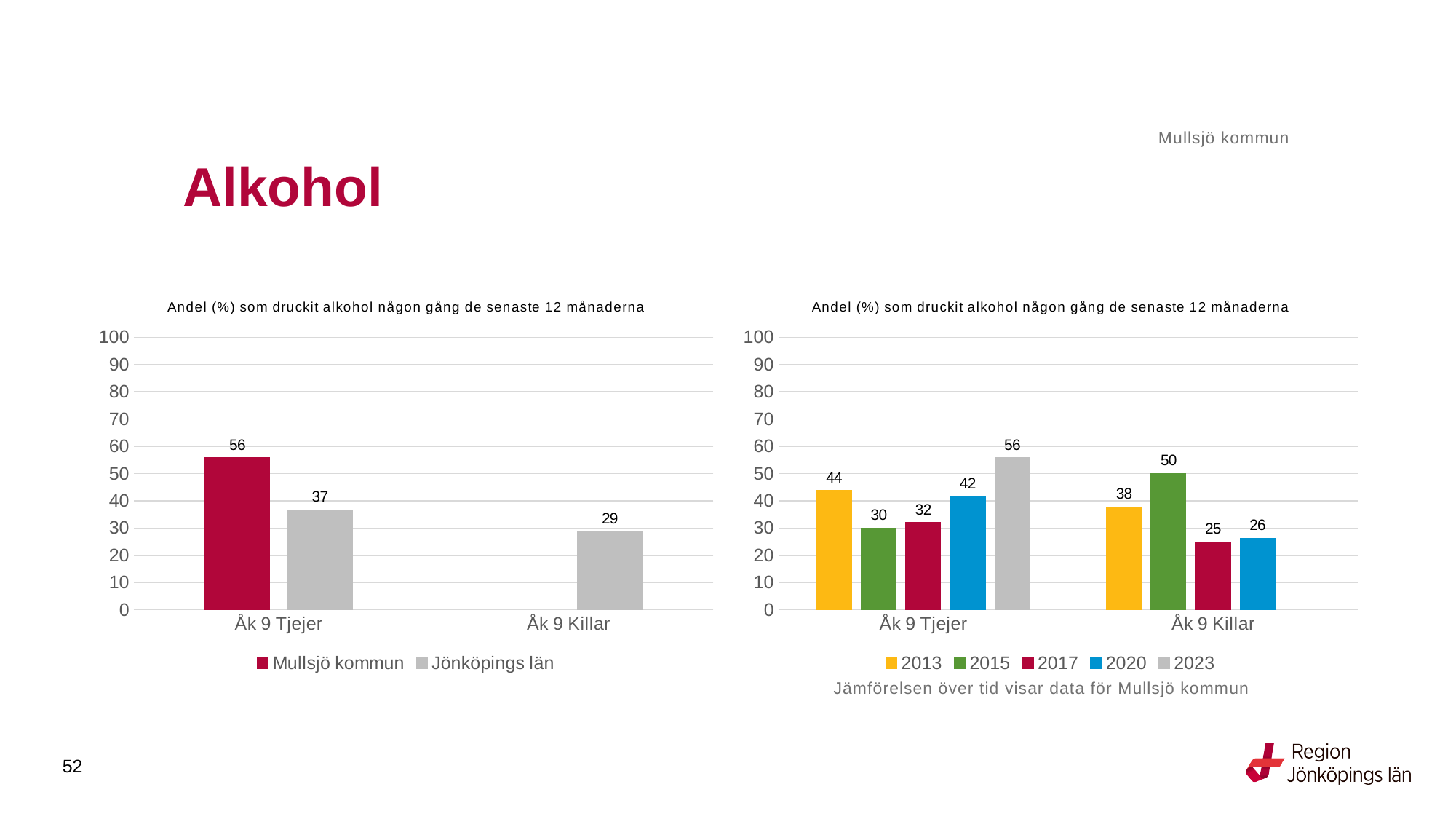
In the left chart, what is the difference between Mullsjö kommun and Jönköpings län for Åk 9 Tjejer? 19 In the right chart, which is larger for Åk 9 Tjejer: the value for 2013 or the value for 2020? 2013 In the right chart, what is the difference between the 2023 and 2013 values for Åk 9 Tjejer? 12 In the right chart, what is the value for 2015 for Åk 9 Killar? 50 What kind of chart is the left chart? Bar chart In the right chart, which year has the highest value for Åk 9 Killar? 2015 In the right chart, which year has the lowest value for Åk 9 Tjejer? 2015 In the left chart, what is the value for Mullsjö kommun for Åk 9 Tjejer? 56 In the right chart, how many series does the legend list? 5 In the left chart, how many series does the legend list? 2 In the right chart, what is the value for 2023 for Åk 9 Tjejer? 56 In the left chart, what is the value for Jönköpings län for Åk 9 Killar? 29